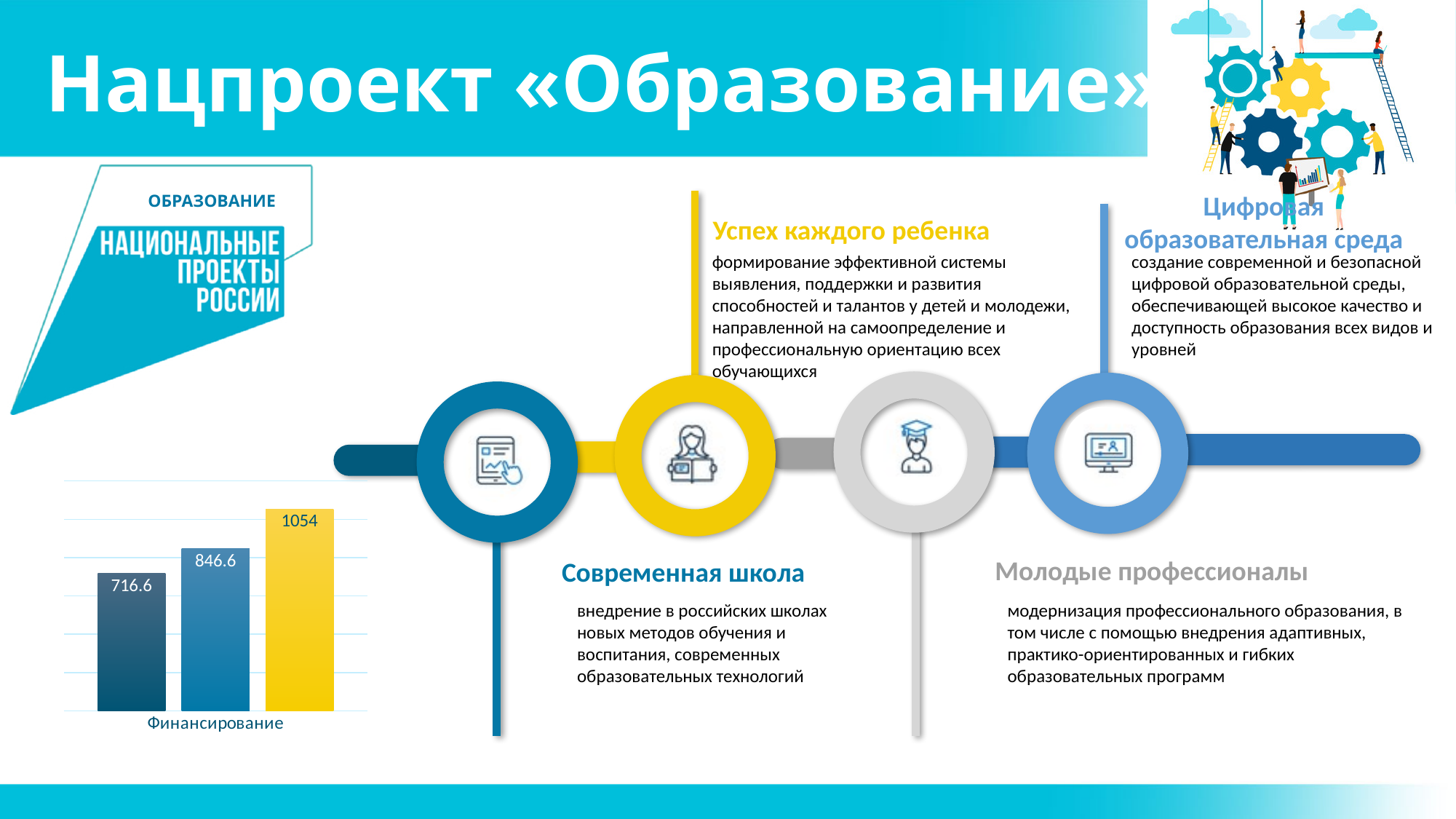
In the "Финансирование" chart, what is the difference between the middle bar and the leftmost bar? 130 What is the value of the yellow bar in the "Финансирование" chart? 1054 Which bar in the "Финансирование" chart has the highest value? the yellow bar (1054) In the "Финансирование" chart, which is larger: the middle bar or the yellow bar? the yellow bar How many bars does the chart under "Финансирование" show? 3 What is the category label shown under the bars of the chart? Финансирование What kind of chart is shown at the bottom left of the slide? bar chart In the "Финансирование" chart, what is the difference between the yellow bar and the dark blue bar? 337.4 Which bar in the "Финансирование" chart has the lowest value? the dark blue bar (716.6) What is the value of the first (leftmost, dark blue) bar in the "Финансирование" chart? 716.6 What is the value of the middle (blue) bar in the "Финансирование" chart? 846.6 Do the bar values in the "Финансирование" chart rise or fall from left to right? rise